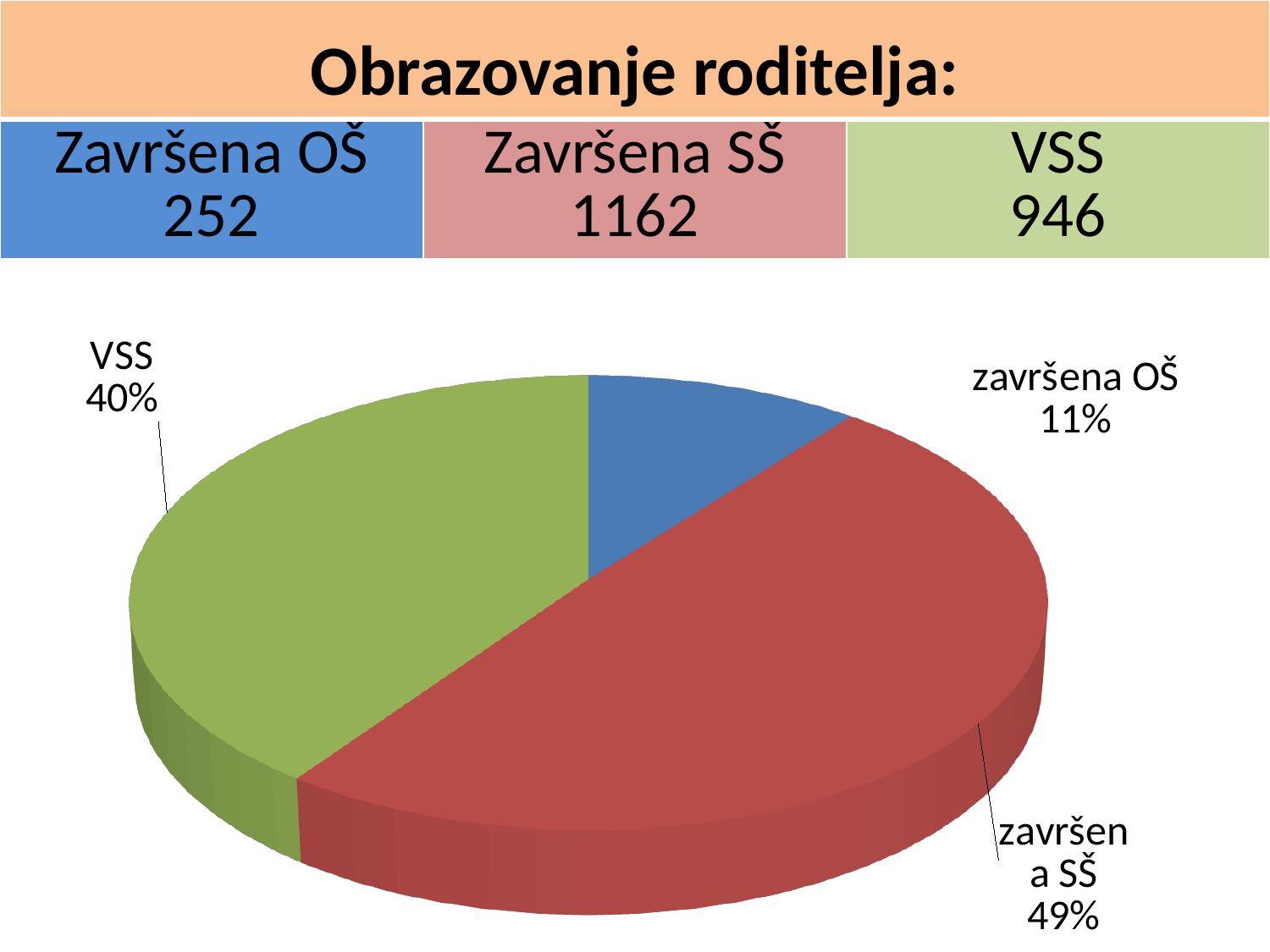
Which category has the smallest slice of the pie? završena OŠ What is the title shown above the chart? Obrazovanje roditelja: Which slice is larger, VSS or završena OŠ? VSS What share of the pie does the završena OŠ slice represent? 11% What share of the pie does the završena SŠ slice represent? 49% What share of the pie does the VSS slice represent? 40% Which category has the largest slice of the pie? završena SŠ What is the difference in percentage points between the VSS slice and the završena OŠ slice? 29% What is the difference in percentage points between the završena SŠ slice and the VSS slice? 9% What kind of chart is shown on the slide? pie chart How many slices does the pie chart have? 3 What colour is the završena SŠ slice of the pie? red